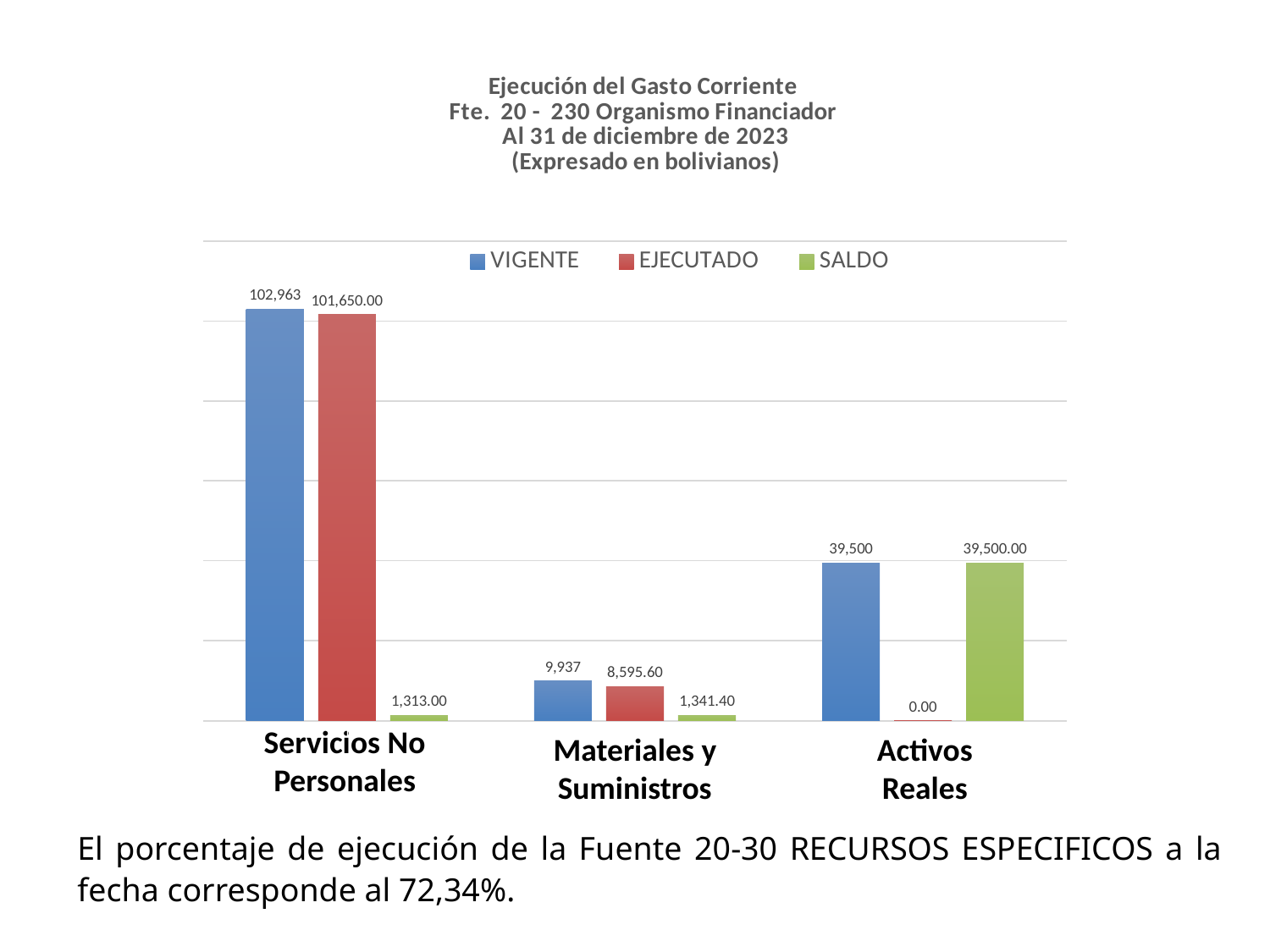
How many series does the legend list? 3 What is the difference between the VIGENTE and EJECUTADO values for Servicios No Personales? 1,313.00 What is the EJECUTADO value for Materiales y Suministros? 8,595.60 Which colour represents the SALDO series? Green Which category has the highest VIGENTE value? Servicios No Personales What is the EJECUTADO value for Activos Reales? 0.00 What kind of chart is shown on the slide? Bar chart What is the VIGENTE value for Servicios No Personales? 102,963 Which is larger for Materiales y Suministros, the VIGENTE value or the SALDO value? VIGENTE How many categories are shown on the x axis? 3 What is the SALDO value for Activos Reales? 39,500.00 Which category has the lowest EJECUTADO value? Activos Reales